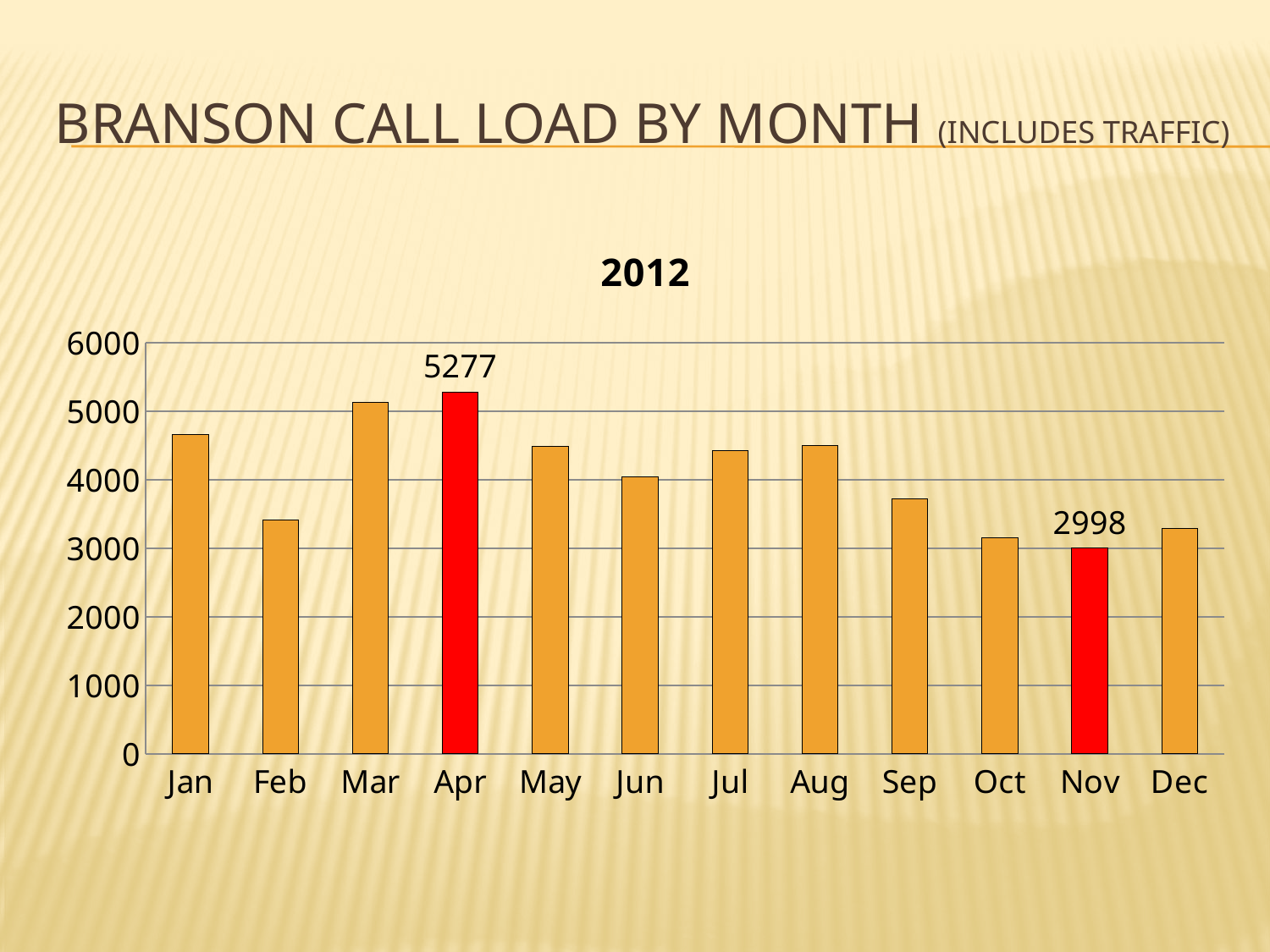
What is the difference between the Apr and Nov call load values? 2279 Is the value for Feb greater or less than 4000? less Which month has the lowest call load? Nov What is the call load value for Apr? 5277 Is the value for Jan greater or less than 4000? greater Is the value for Mar greater or less than 5000? greater What kind of chart is shown on the slide? bar chart How many months are shown on the x axis? 12 Which month has the highest call load? Apr Which month has a larger call load, Mar or Feb? Mar What is the call load value for Nov? 2998 What is the title of the chart? 2012